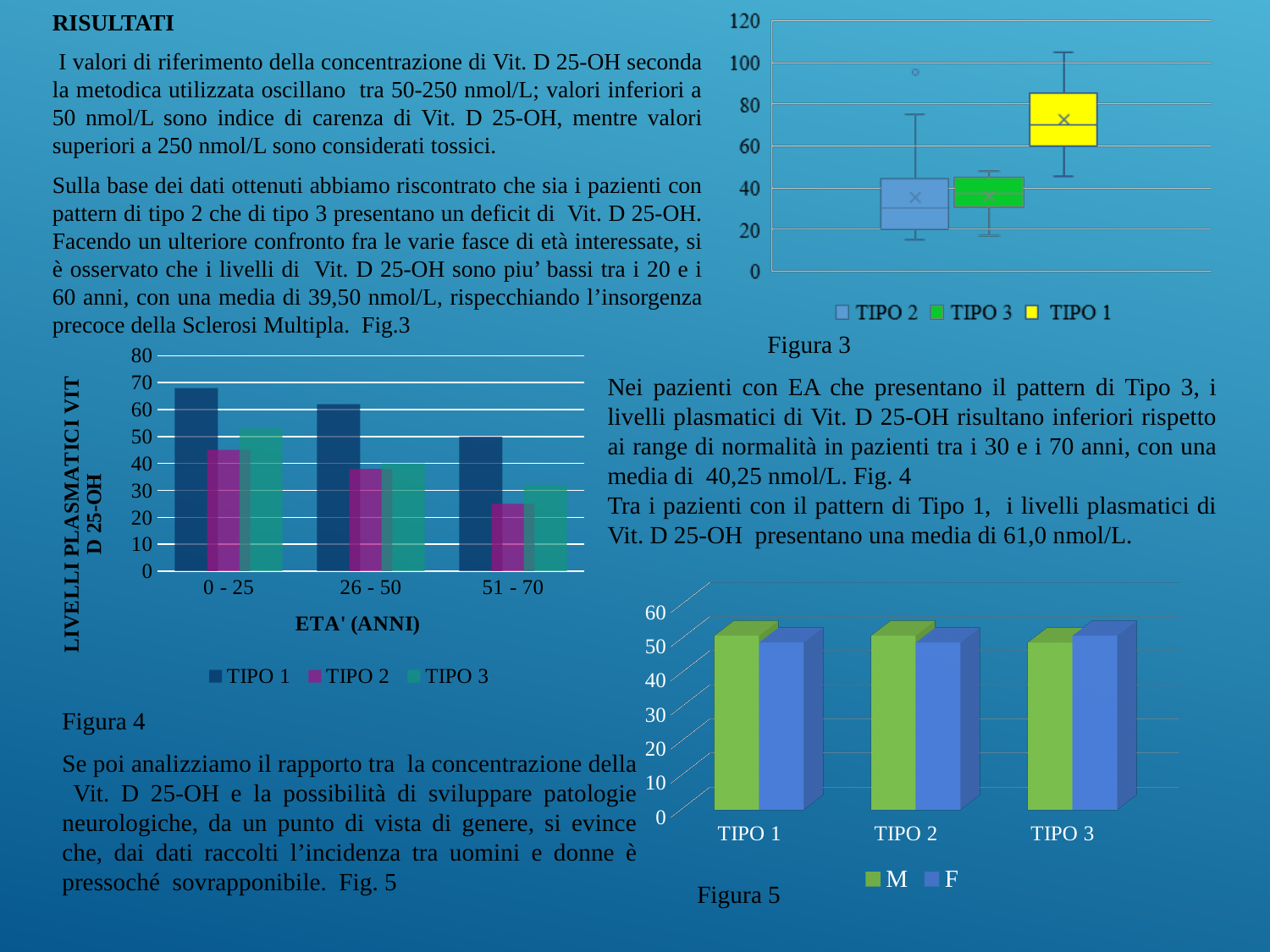
In Figura 4, is the TIPO 2 value for the 51 - 70 age group greater or less than 30? less In Figura 3, which series is shown in yellow in the legend? TIPO 1 In Figura 4, which age group has the highest TIPO 1 value? 0 - 25 In Figura 4, do the TIPO 1 values rise or fall as the age group increases along the x axis? fall In Figura 4, what kind of chart is shown? bar chart In Figura 4, which age group has the lowest TIPO 2 value? 51 - 70 In Figura 4, for the 26 - 50 age group, which is larger: TIPO 1 or TIPO 2? TIPO 1 In Figura 4, how many age-group categories are shown on the x axis? 3 In Figura 4, how many series does the legend list? 3 In Figura 5, how many series does the legend list? 2 In Figura 4, is the TIPO 1 value for the 0 - 25 age group greater or less than 60? greater In Figura 5, is the M value for TIPO 1 greater or less than 40? greater